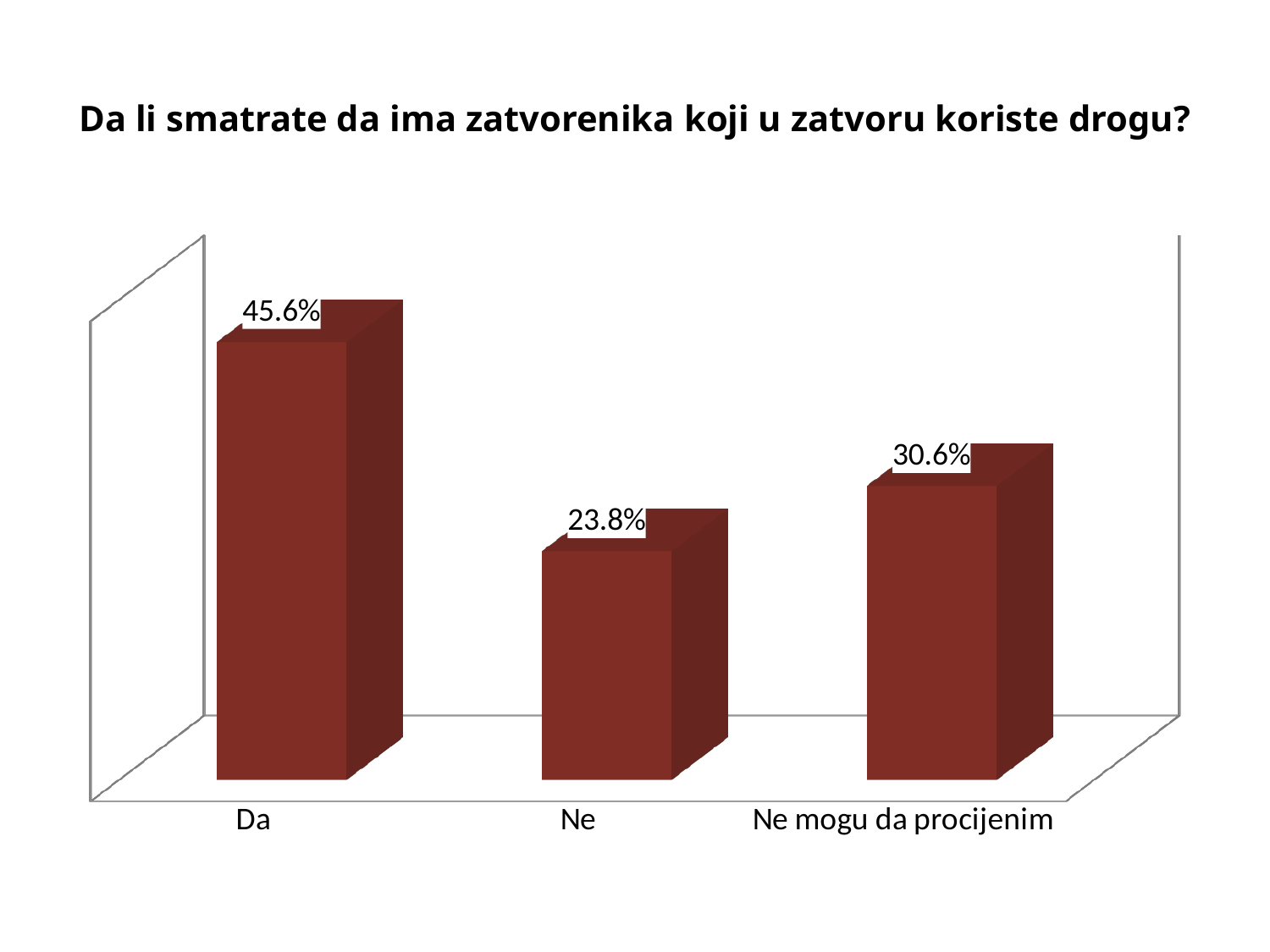
Which category has the lowest value? Ne What is the difference between the values for "Ne mogu da procijenim" and "Ne"? 6.8% What is the difference between the values for "Da" and "Ne"? 21.8% Which is larger, the value for "Ne" or the value for "Ne mogu da procijenim"? Ne mogu da procijenim What is the value for "Ne mogu da procijenim"? 30.6% What colour are the bars in the chart? Dark red What kind of chart is shown on the slide? Bar chart Which category has the highest value? Da What is the title of the chart? Da li smatrate da ima zatvorenika koji u zatvoru koriste drogu? How many categories are shown in the chart? 3 What is the value for "Da"? 45.6% What is the value for "Ne"? 23.8%